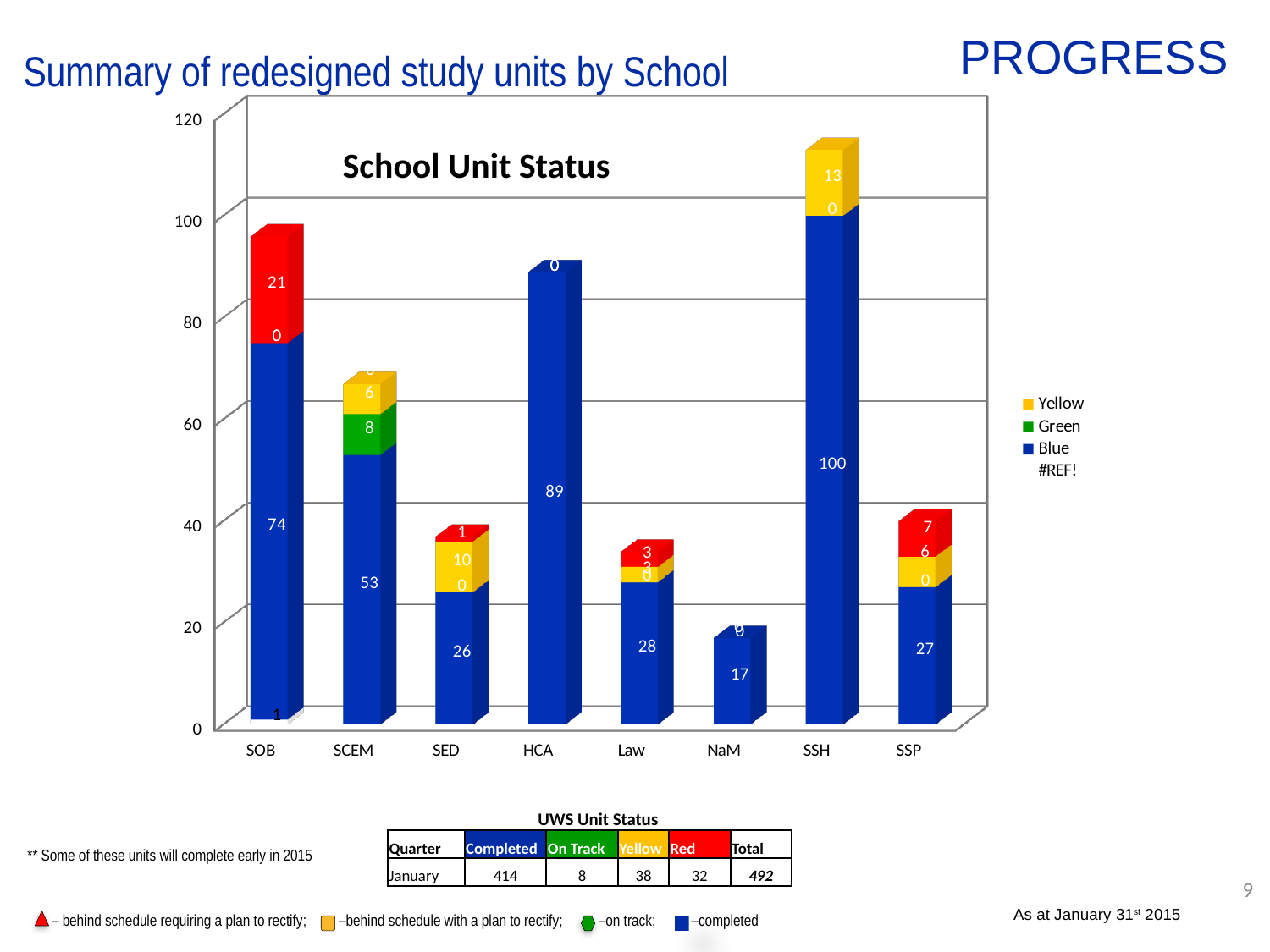
What is the Green value for SCEM? 8 What is the Blue value for NaM? 17 What is the red segment value for SOB? 21 What is the title of the chart? School Unit Status Which has a larger Blue value, SOB or SCEM? SOB What is the Blue value for HCA? 89 What is the Yellow value for SSH? 13 What is the difference between the Blue values for SSH and HCA? 11 Which school has the lowest Blue value? NaM What is the Blue value for SSH in the School Unit Status chart? 100 Which school has the highest Blue value? SSH How many schools are shown on the x axis of the chart? 8